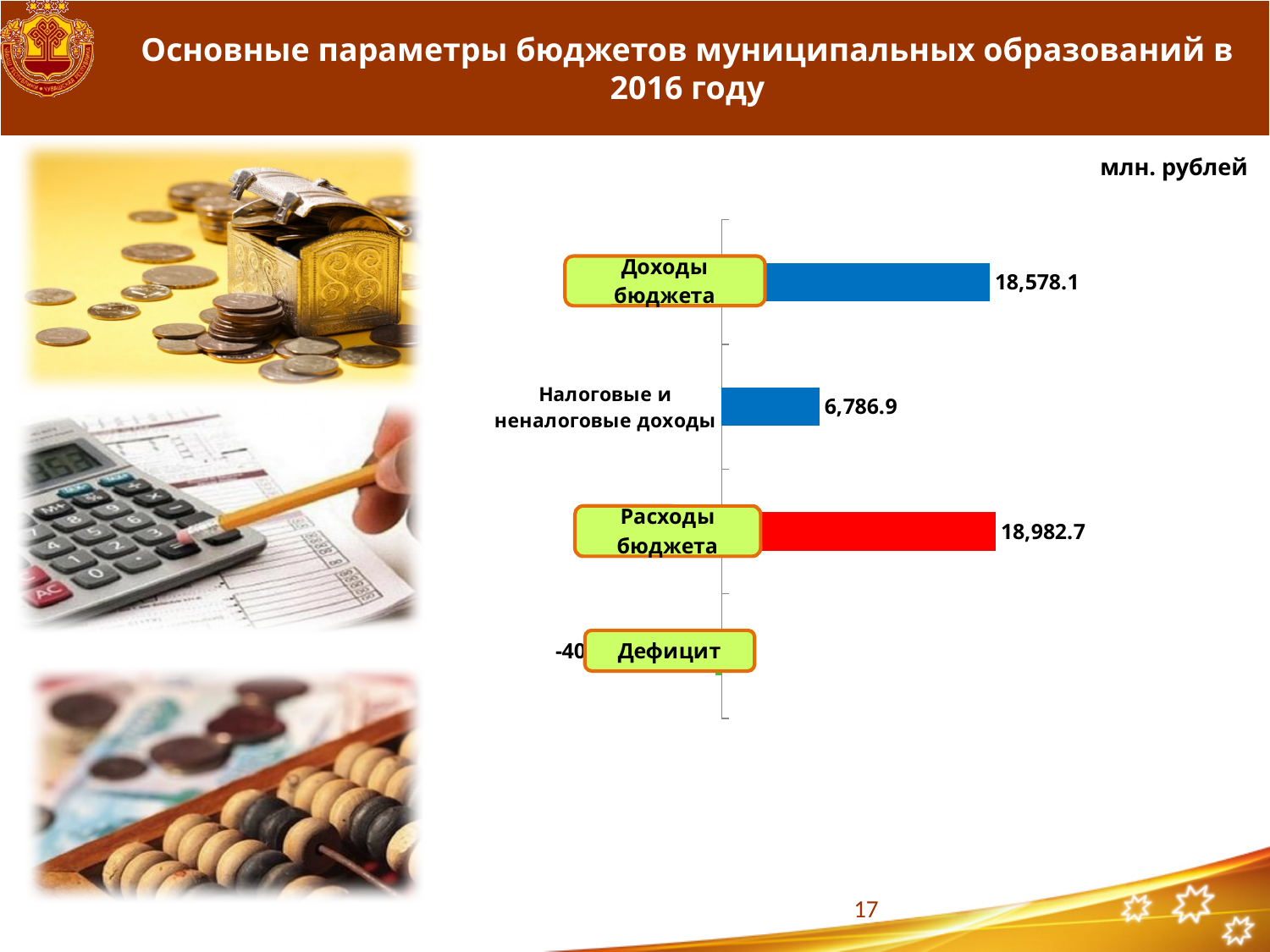
What is the value for Доходы бюджета? 18,578.1 What is the value for Налоговые и неналоговые доходы? 6,786.9 How many categories are shown on the chart? 4 In what units are the chart values given? млн. рублей Which is larger, Доходы бюджета or Расходы бюджета? Расходы бюджета Which of the categories with a printed value has the lowest value? Налоговые и неналоговые доходы What is the difference between Расходы бюджета and Доходы бюджета? 404.6 What kind of chart is shown on the slide? Bar chart Which category has the highest value on the chart? Расходы бюджета What colour is the bar for Расходы бюджета? Red What is the difference between Доходы бюджета and Налоговые и неналоговые доходы? 11,791.2 What is the value for Расходы бюджета? 18,982.7